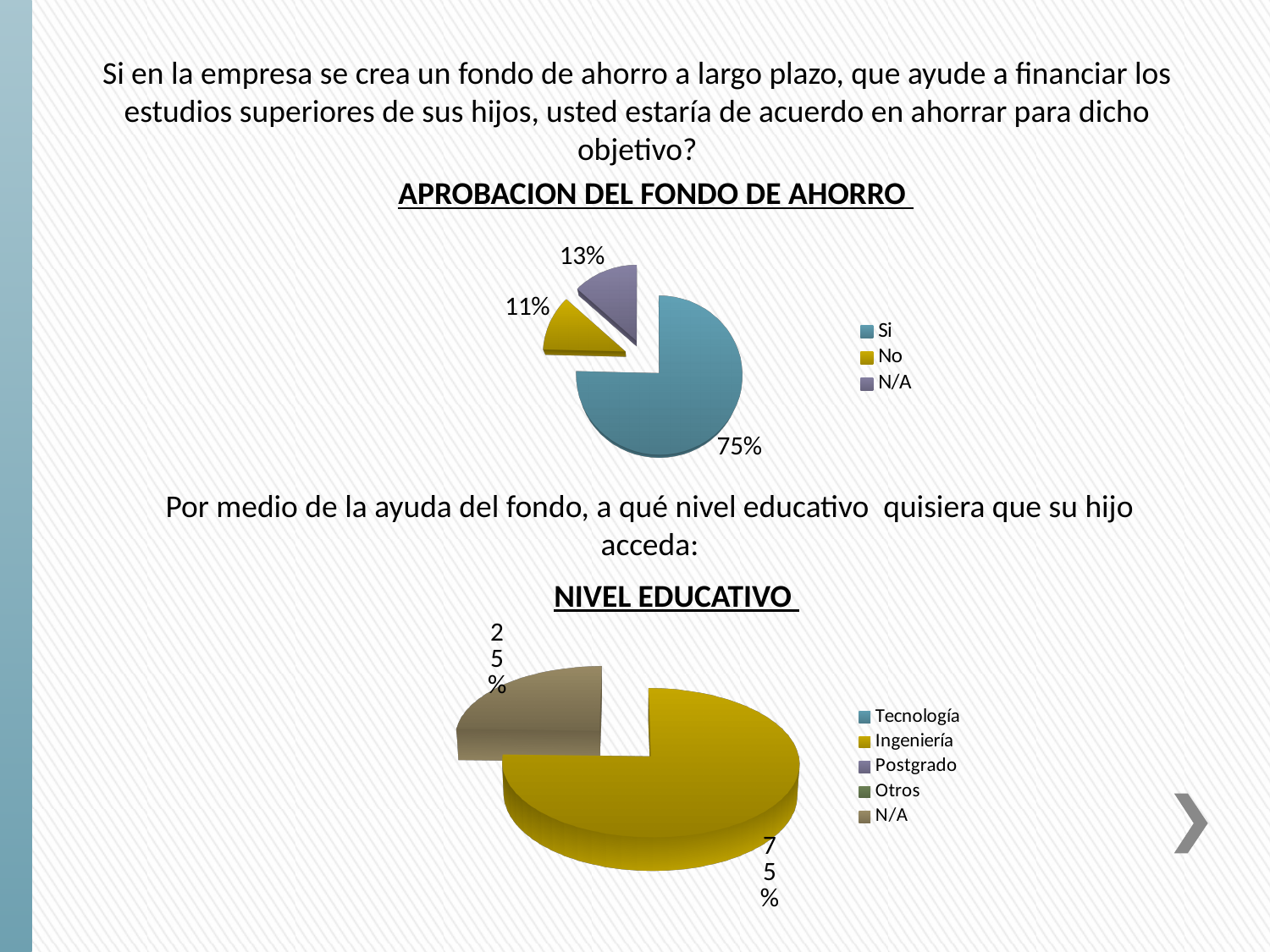
What kind of chart is the APROBACION DEL FONDO DE AHORRO chart? Pie chart In the NIVEL EDUCATIVO chart, what percentage is shown for N/A? 25% In the APROBACION DEL FONDO DE AHORRO chart, what percentage of respondents answered No? 11% In the NIVEL EDUCATIVO chart, how many entries does the legend list? 5 In the APROBACION DEL FONDO DE AHORRO chart, what percentage of respondents answered Si? 75% In the APROBACION DEL FONDO DE AHORRO chart, which response has the largest share? Si In the APROBACION DEL FONDO DE AHORRO chart, which response has the smallest share? No In the NIVEL EDUCATIVO chart, what percentage is shown for Ingeniería? 75% In the APROBACION DEL FONDO DE AHORRO chart, how many entries does the legend list? 3 In the NIVEL EDUCATIVO chart, which is larger, Ingeniería or N/A? Ingeniería In the APROBACION DEL FONDO DE AHORRO chart, what is the difference in percentage points between Si and N/A? 62 In the APROBACION DEL FONDO DE AHORRO chart, what percentage is shown for N/A? 13%